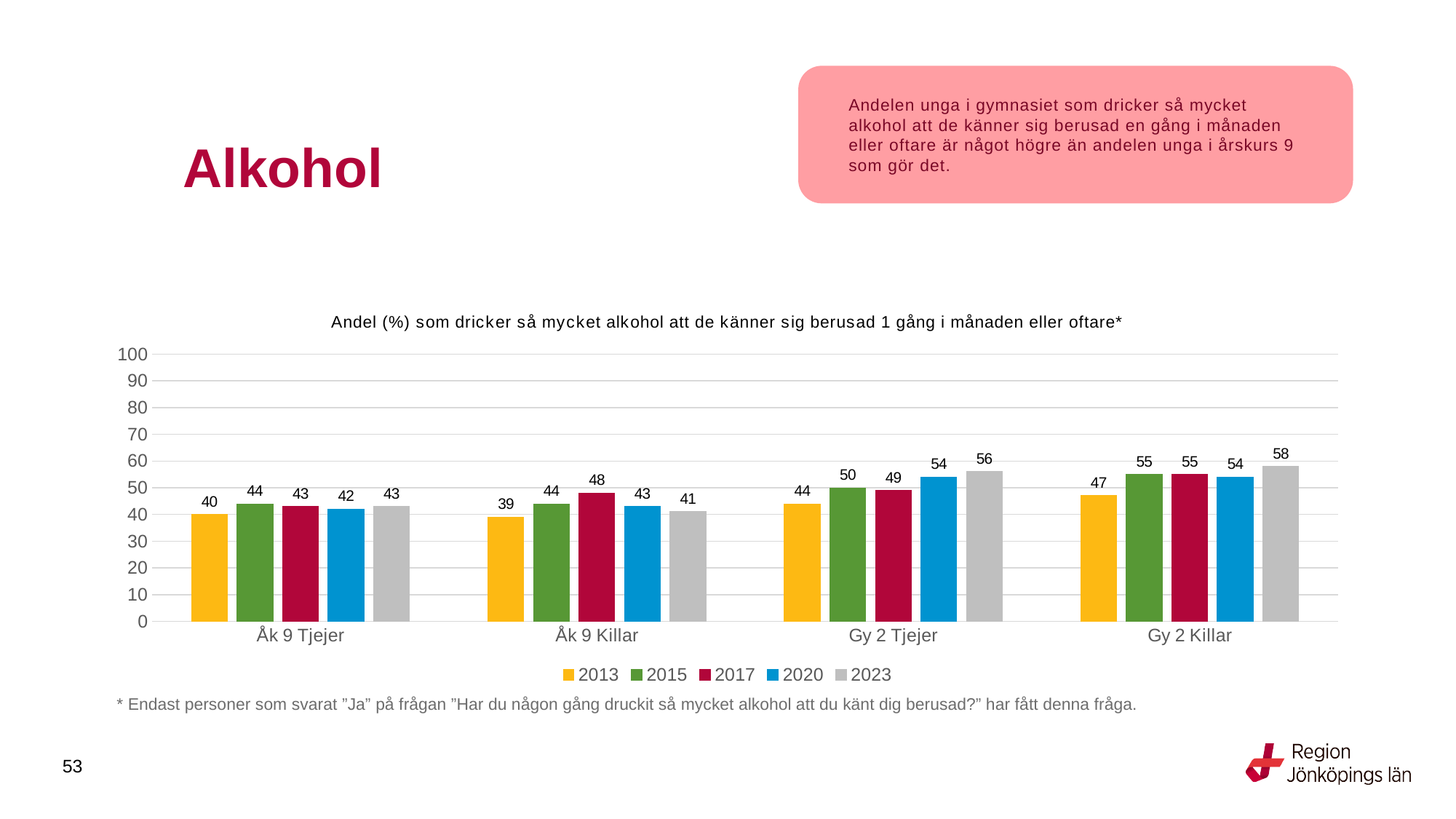
What is the value for Gy 2 Killar in 2023? 58 Is the value for Gy 2 Killar in 2015 greater or less than 50? greater What is the difference between the 2023 values for Gy 2 Tjejer and Åk 9 Tjejer? 13 Which is larger: the 2020 value for Gy 2 Tjejer or the 2020 value for Åk 9 Killar? Gy 2 Tjejer What is the title of the chart? Andel (%) som dricker så mycket alkohol att de känner sig berusad 1 gång i månaden eller oftare* Which category has the lowest value in 2013? Åk 9 Killar How many categories are shown on the x axis? 4 Which category has the highest value in 2023? Gy 2 Killar How many series does the legend list? 5 What kind of chart is shown on the slide? bar chart What is the value for Åk 9 Killar in 2017? 48 What is the value for Åk 9 Tjejer in 2013? 40